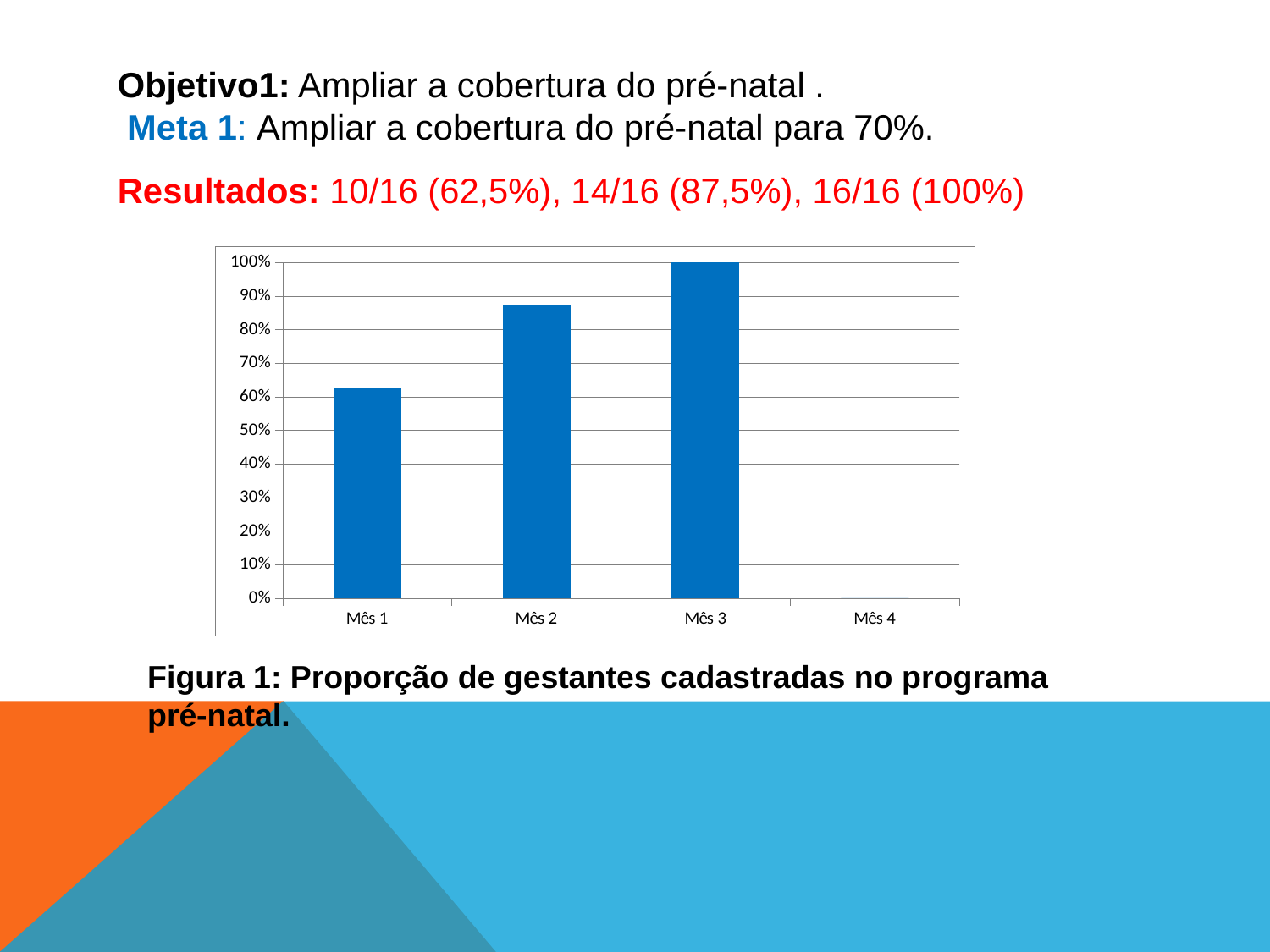
Is the value for Mês 1 greater or less than 70%? less Is the value for Mês 1 greater or less than 60%? greater Which month has the lowest value in the chart? Mês 4 Do the values rise or fall from Mês 1 to Mês 3? rise What is the value for Mês 3 in the chart? 100% What kind of chart is shown on the slide? bar chart Which month has the highest bar in the chart? Mês 3 What colour are the bars in the chart? blue Which is larger, the value for Mês 1 or the value for Mês 2? Mês 2 Is the value for Mês 2 greater or less than 80%? greater What is the caption given for the chart (Figura 1)? Proporção de gestantes cadastradas no programa pré-natal. How many categories are shown on the x axis of the chart? 4